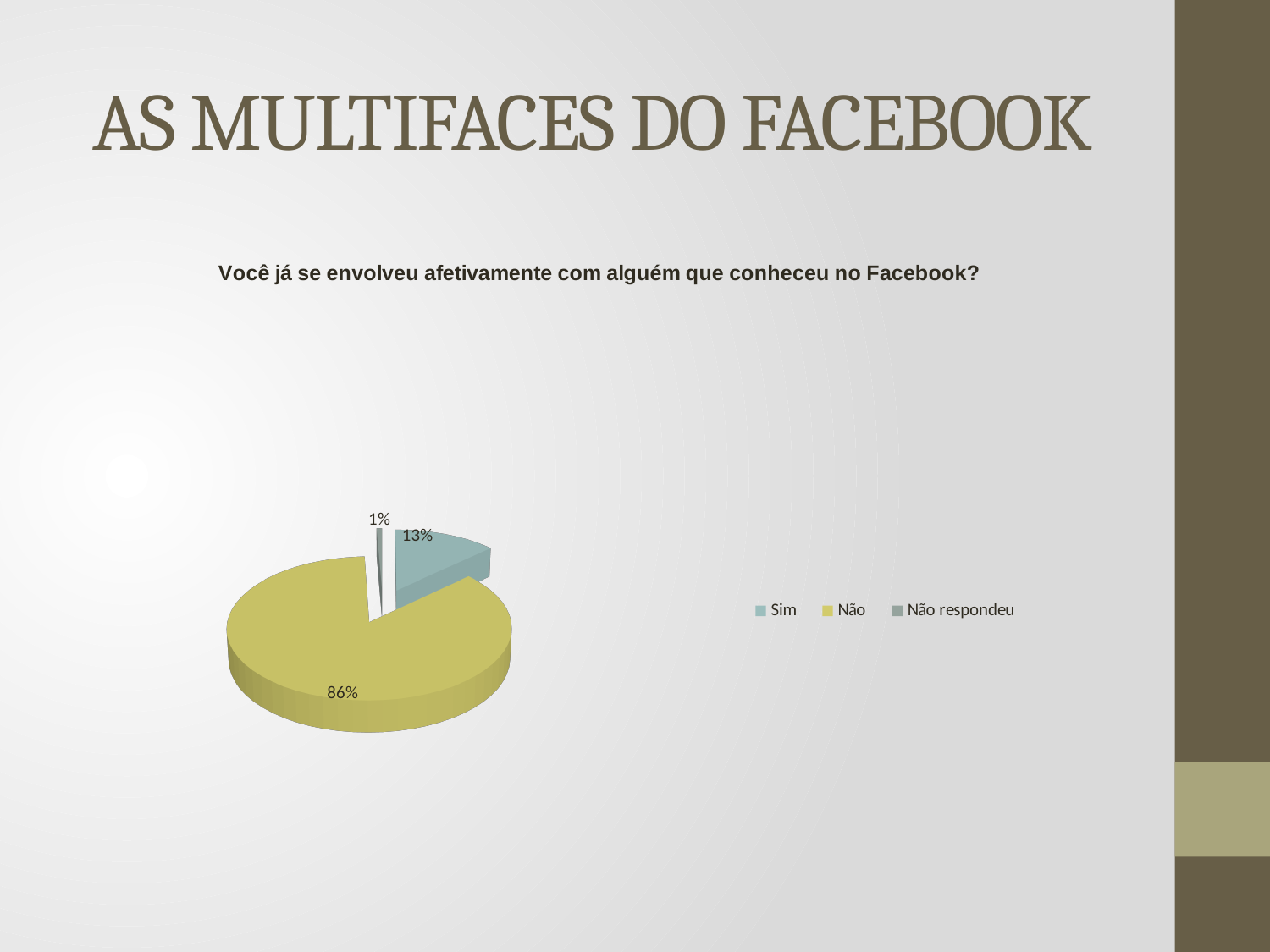
What is the title of the chart? Você já se envolveu afetivamente com alguém que conheceu no Facebook? Which is larger, the "Sim" slice or the "Não respondeu" slice? Sim How many categories does the legend list? 3 What share of the pie does "Não" represent? 86% What is the difference in percentage points between the "Não" and "Sim" slices? 73 Which category has the largest slice of the pie? Não What share of the pie does "Sim" represent? 13% What colour is the "Não" slice? yellow Which category has the smallest slice of the pie? Não respondeu What share of the pie does "Não respondeu" represent? 1% What kind of chart is shown on the slide? pie chart